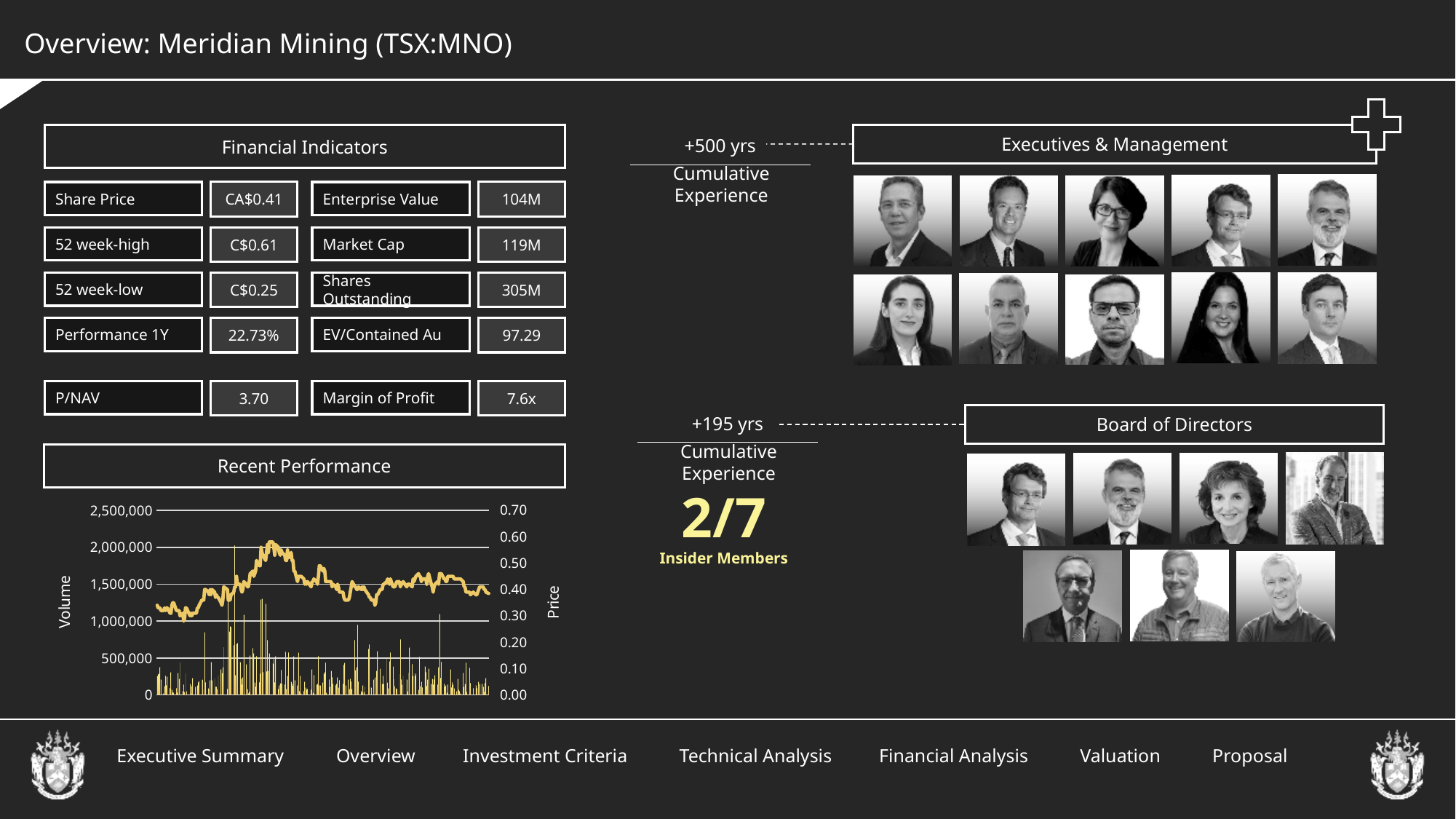
What is the highest value shown on the Volume axis of the Recent Performance chart? 2,500,000 What is the label of the left vertical axis on the Recent Performance chart? Volume On the Recent Performance chart, is the tallest volume bar greater or less than 1,000,000? greater On the Recent Performance chart, does the price line end higher or lower than where it starts? higher What is the highest value shown on the Price axis of the Recent Performance chart? 0.70 What is the title of the chart on the slide? Recent Performance On the Recent Performance chart, is the peak of the price line greater or less than 0.50? greater What kind of chart is the Recent Performance chart? A combination chart with bars and a line On the Recent Performance chart, is the lowest point of the price line greater or less than 0.20? greater How many tick labels are shown on the Price axis of the Recent Performance chart? 8